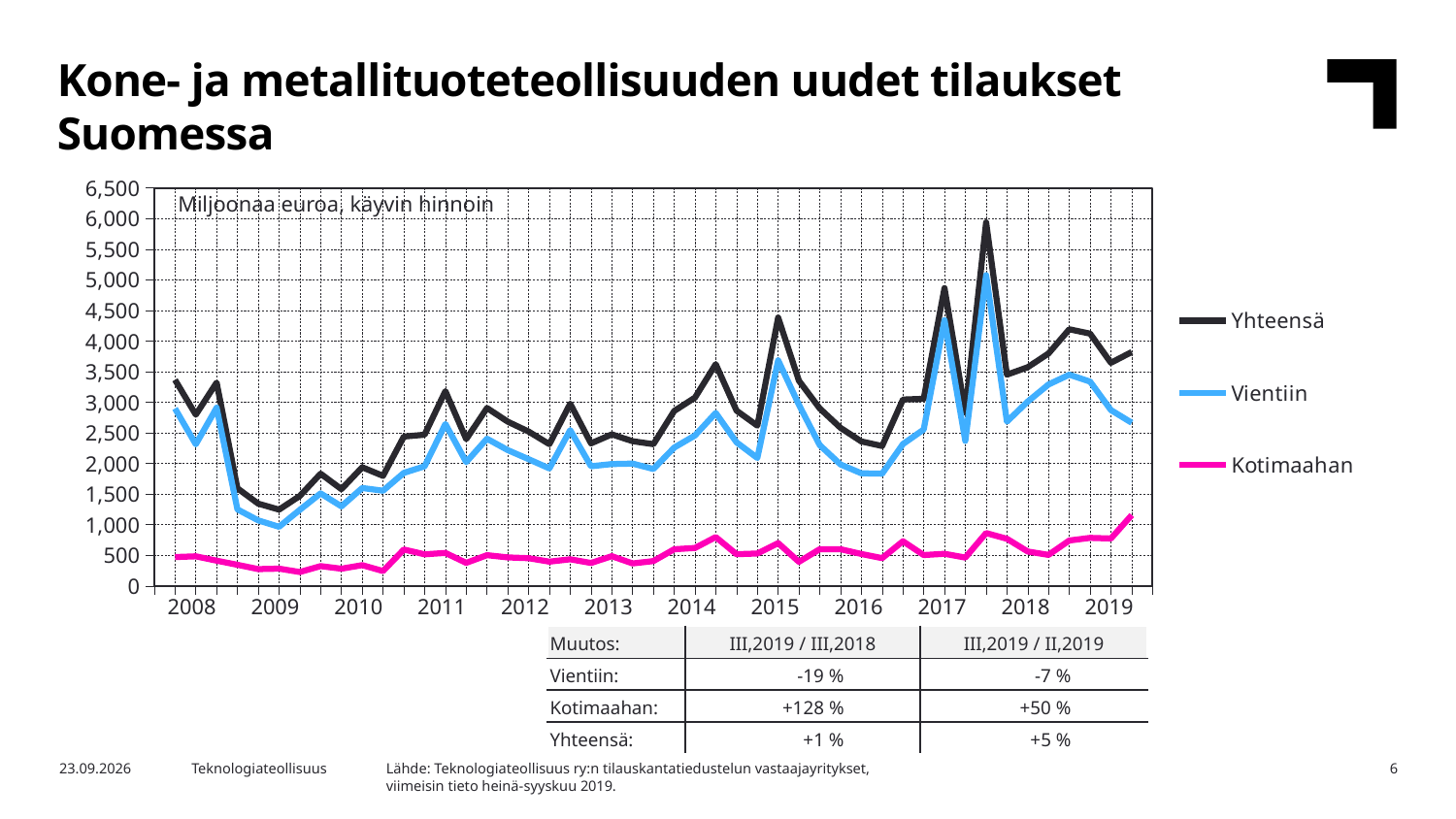
Is the highest peak of the Yhteensä series greater or less than 5,500? greater In which year does the Yhteensä series reach its highest peak? 2017 What unit label is printed inside the chart area? Miljoonaa euroa, käyvin hinnoin What kind of chart is shown on the slide? line chart What are the three series named in the legend? Yhteensä, Vientiin, Kotimaahan Is the highest peak of the Vientiin series greater or less than 4,500? greater Is the highest value of the Kotimaahan series greater or less than 1,500? less How many series does the legend list? 3 Does the Yhteensä series rise or fall from the start of 2008 to 2009? fall Which series has the lowest values throughout the chart? Kotimaahan How many years are labelled on the x axis? 12 Which series has the highest values throughout the chart? Yhteensä